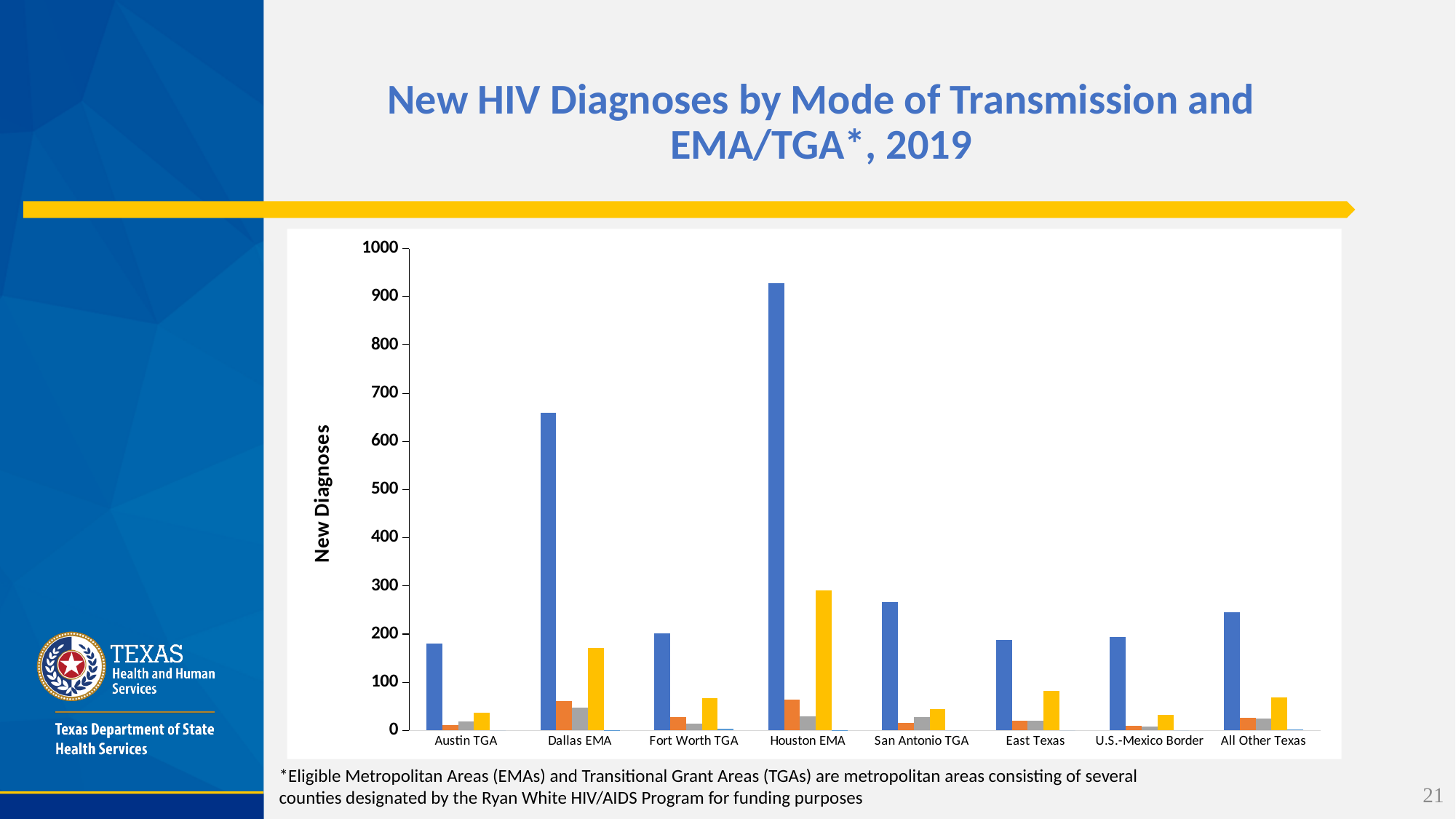
What kind of chart is shown on the slide? bar chart Which has the larger yellow bar, Fort Worth TGA or Dallas EMA? Dallas EMA Which category has the tallest blue bar? Houston EMA Is the blue bar for Austin TGA greater or less than 200? less How many EMA/TGA categories are shown along the x axis? 8 What is the label on the vertical axis of the chart? New Diagnoses Is the blue bar for Houston EMA greater or less than 900? greater Which category has the tallest yellow bar? Houston EMA Which has the larger blue bar, Dallas EMA or Houston EMA? Houston EMA Is the yellow bar for Houston EMA greater or less than 200? greater